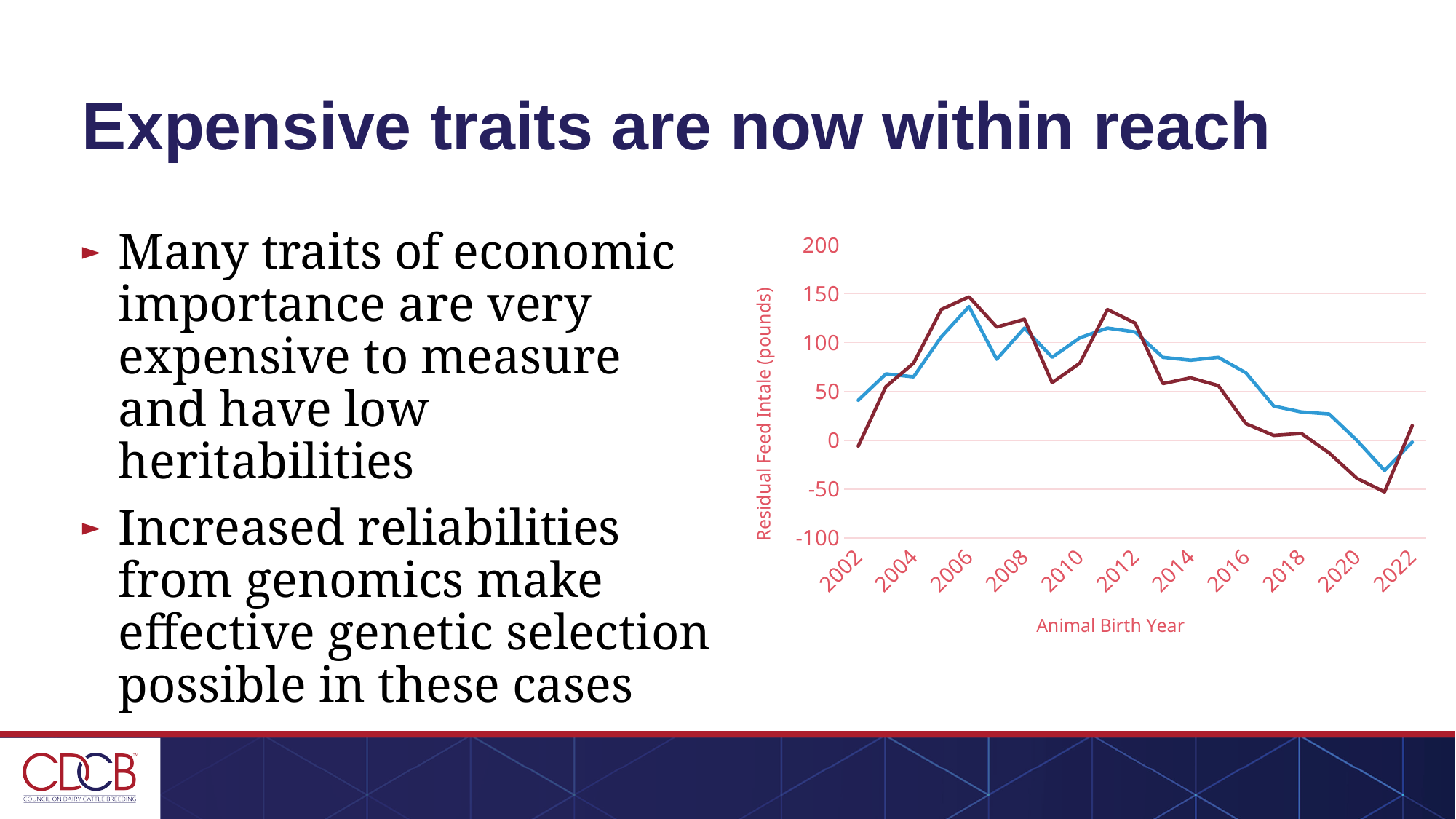
Is the value of the red line in 2016 greater or less than 50? less Do the values of the blue line rise or fall between 2012 and 2020? fall How many lines are plotted on the chart? 2 In 2020, which line has the higher value, the red line or the blue line? blue line What kind of chart is shown on the slide? line chart In which labelled year does the red line reach its highest value? 2006 Is the value of the red line in 2006 greater or less than 100? greater How many year labels are shown on the x axis of the chart? 11 What is the title of the x axis of the chart? Animal Birth Year In 2012, which line has the higher value, the red line or the blue line? red line